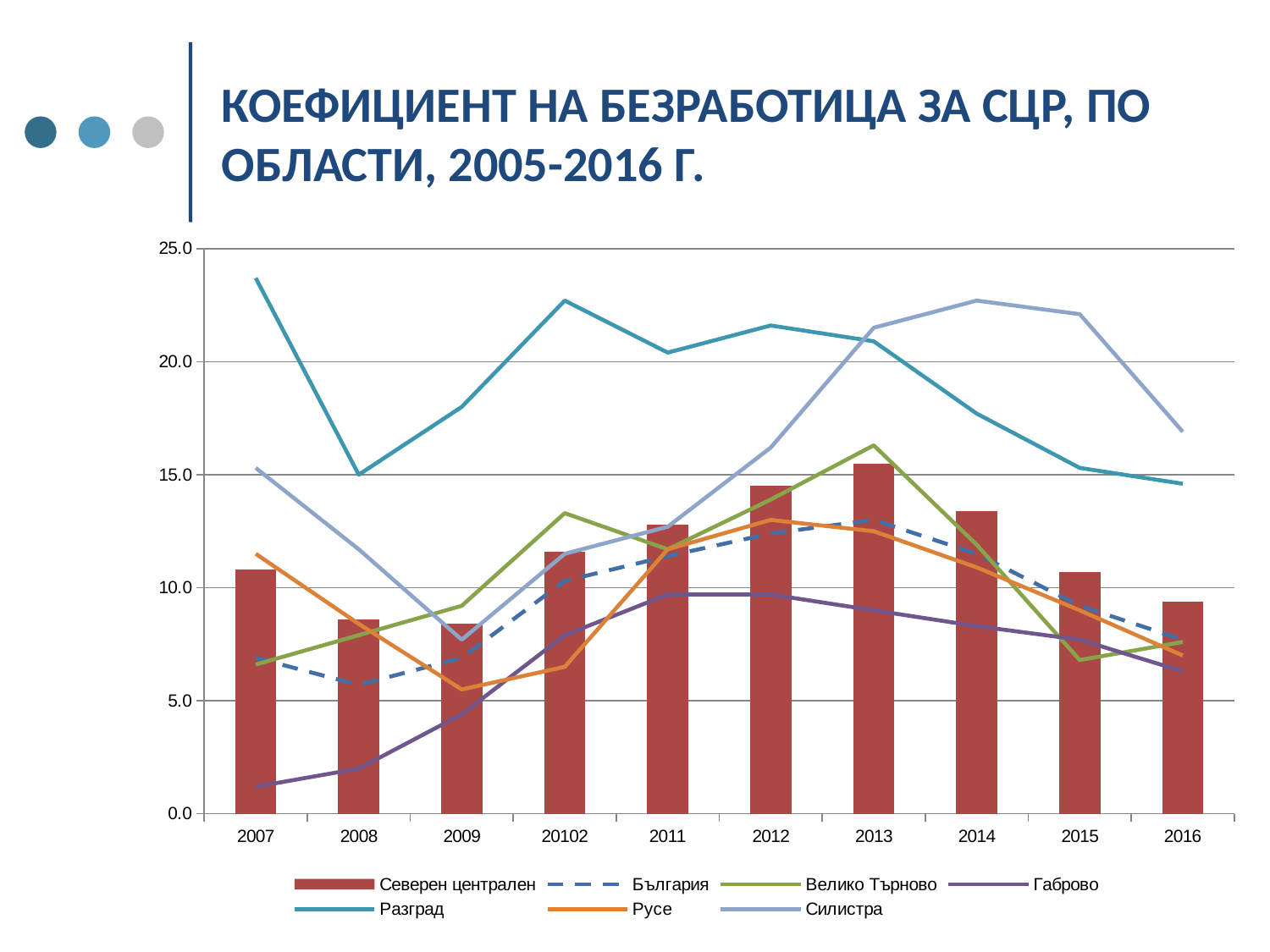
Which is larger, the value for Разград in 2007 or in 2008? 2007 In which year is the bar for Северен централен the highest? 2013 How many series does the legend list? 7 Is the value for Северен централен in 2013 greater or less than 15? greater Does the Габрово line rise or fall from 2007 to 2011? rises How many years (categories) are shown on the x axis? 10 What kind of chart is shown on the slide? A combined bar and line chart Is the value for Разград in 2007 greater or less than 20? greater Which series is drawn as a dashed line? България Is the value for Силистра in 2014 greater or less than 20? greater